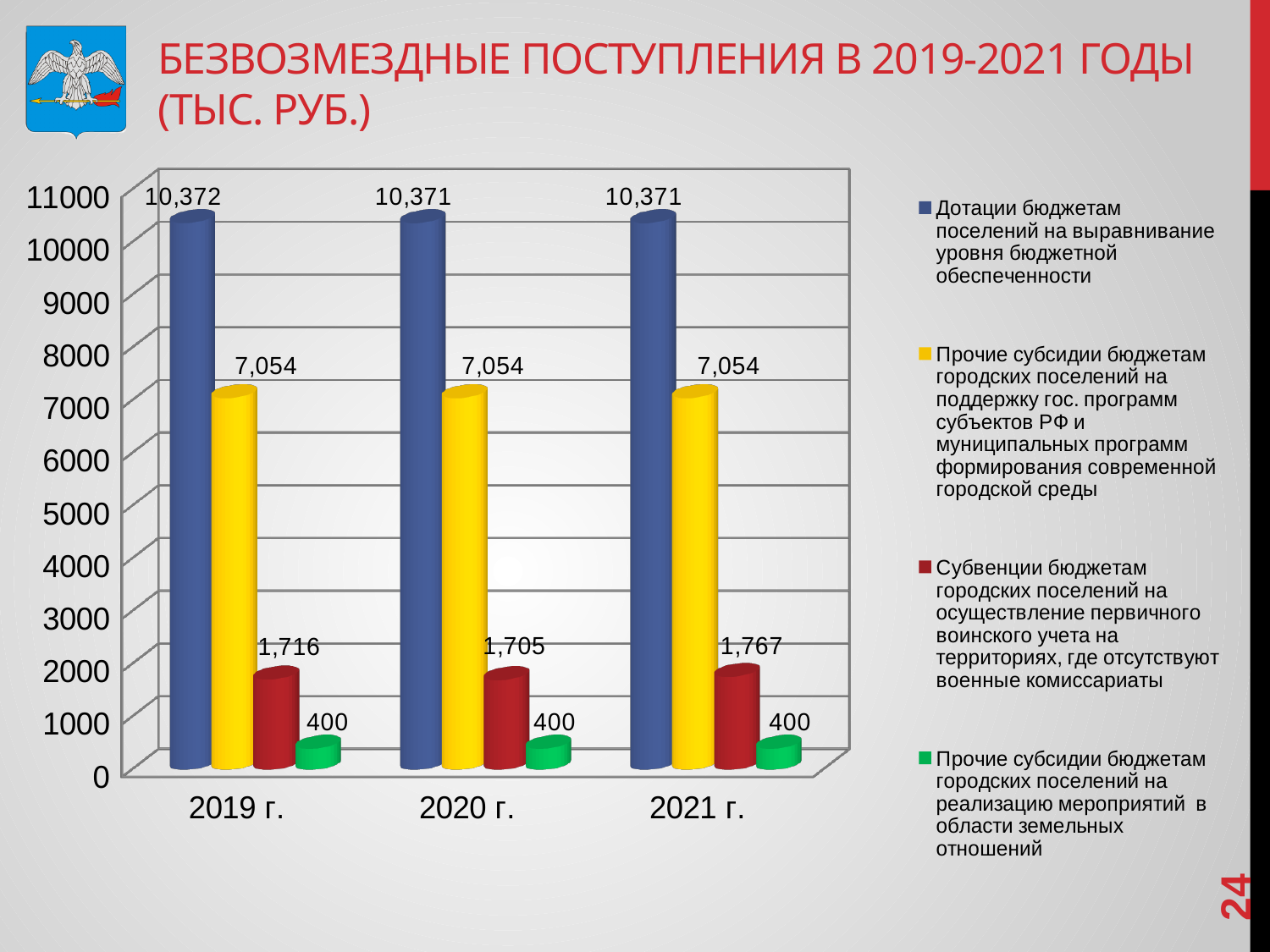
What is the value of the yellow series (Прочие субсидии бюджетам городских поселений на поддержку гос. программ) for 2020 г.? 7,054 What is the value of the blue series (Дотации бюджетам поселений на выравнивание уровня бюджетной обеспеченности) for 2019 г.? 10,372 In which year is the red series (Субвенции) highest? 2021 г. What is the difference between the red series values in 2021 г. and 2020 г.? 62 How many series does the legend list? 4 Which is larger in 2020 г.: the yellow series value or the red series value? the yellow series (7,054) How many years (categories) are shown on the x axis? 3 What is the difference between the blue series value and the yellow series value in 2019 г.? 3,318 What is the value of the red series (Субвенции бюджетам городских поселений на осуществление первичного воинского учета) for 2021 г.? 1,767 What kind of chart is shown on the slide? bar chart In which year is the red series (Субвенции) lowest? 2020 г. What is the value of the green series (Прочие субсидии бюджетам городских поселений на реализацию мероприятий в области земельных отношений) for 2019 г.? 400